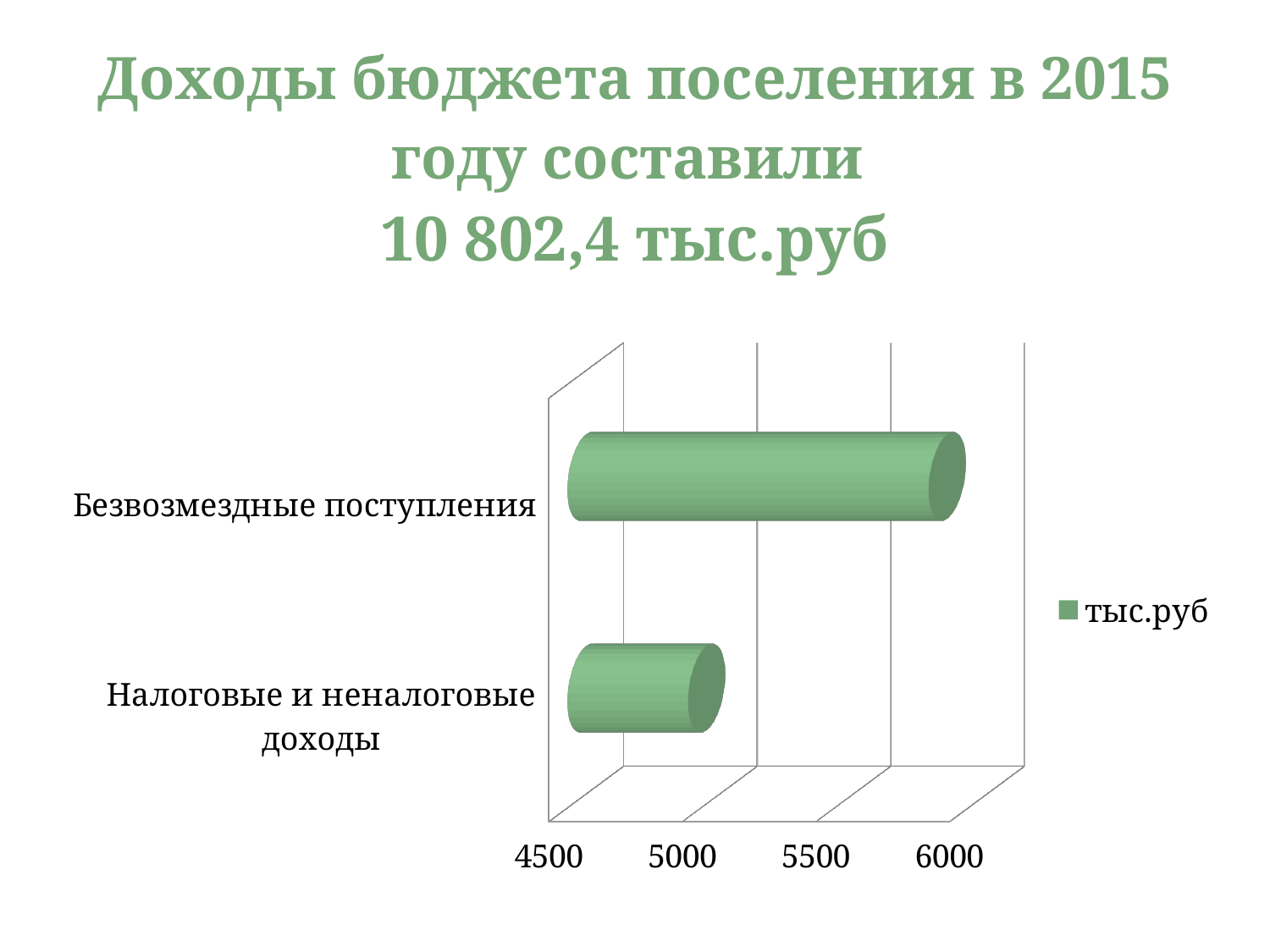
Is the value for Безвозмездные поступления greater or less than 6000? less Which is larger: Безвозмездные поступления or Налоговые и неналоговые доходы? Безвозмездные поступления Which category has the highest value? Безвозмездные поступления Which category has the lowest value? Налоговые и неналоговые доходы How many series does the legend list? 1 According to the slide title, what was the total budget income of the settlement in 2015? 10 802,4 тыс.руб Is the value for Налоговые и неналоговые доходы greater or less than 5500? less What kind of chart is shown on the slide? bar chart How many categories are plotted in the chart? 2 What series name is shown in the chart legend? тыс.руб Is the value for Налоговые и неналоговые доходы greater or less than 4500? greater